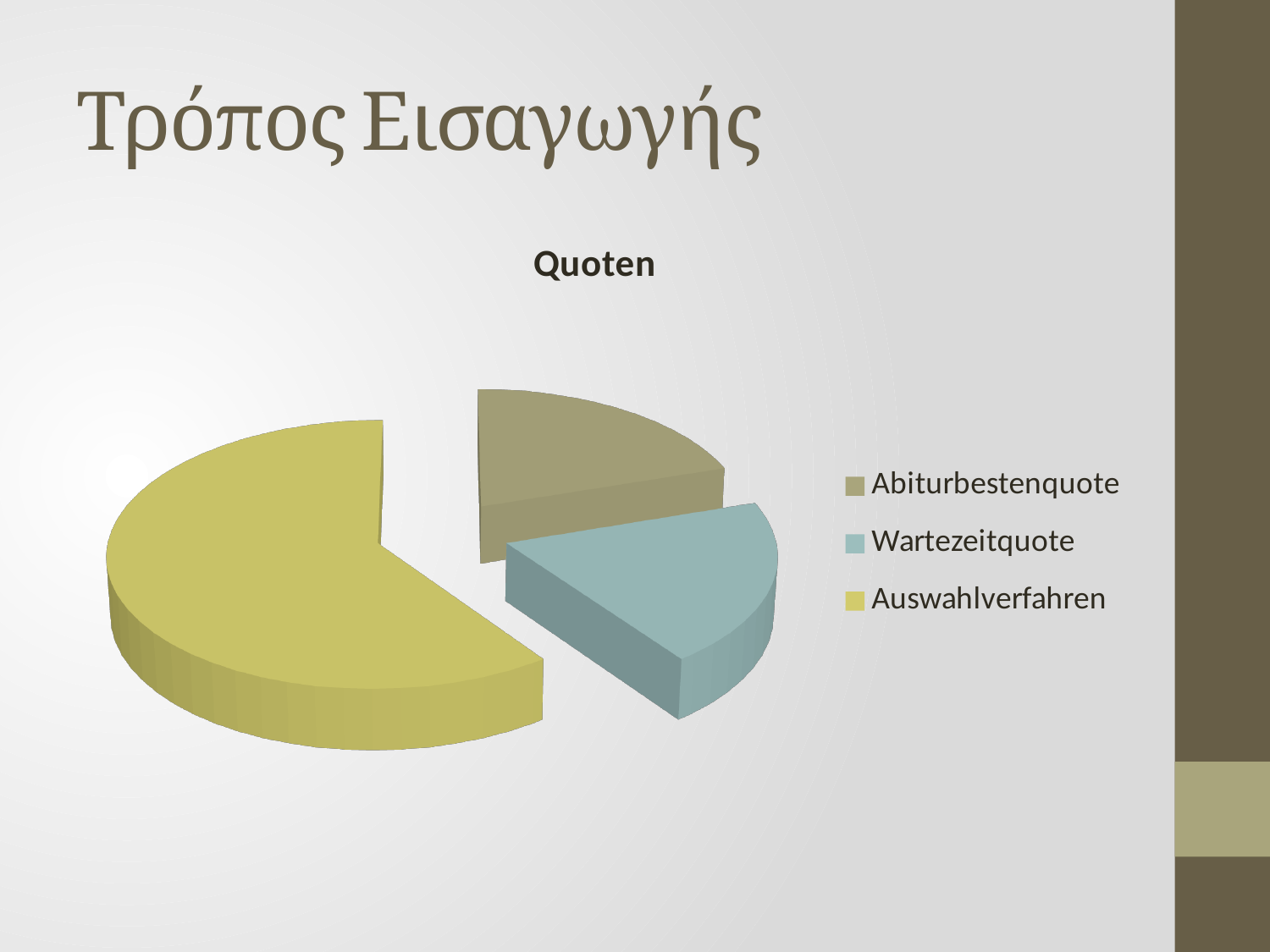
Which category has the largest slice of the pie? Auswahlverfahren Which is larger, the slice for Auswahlverfahren or the slice for Wartezeitquote? Auswahlverfahren How many slices does the pie chart have? 3 How many entries does the legend list? 3 Which legend entry is shown in the yellow-green colour? Auswahlverfahren What kind of chart is shown on the slide? pie chart What is the title of the chart? Quoten Which is larger, the slice for Abiturbestenquote or the slice for Auswahlverfahren? Auswahlverfahren